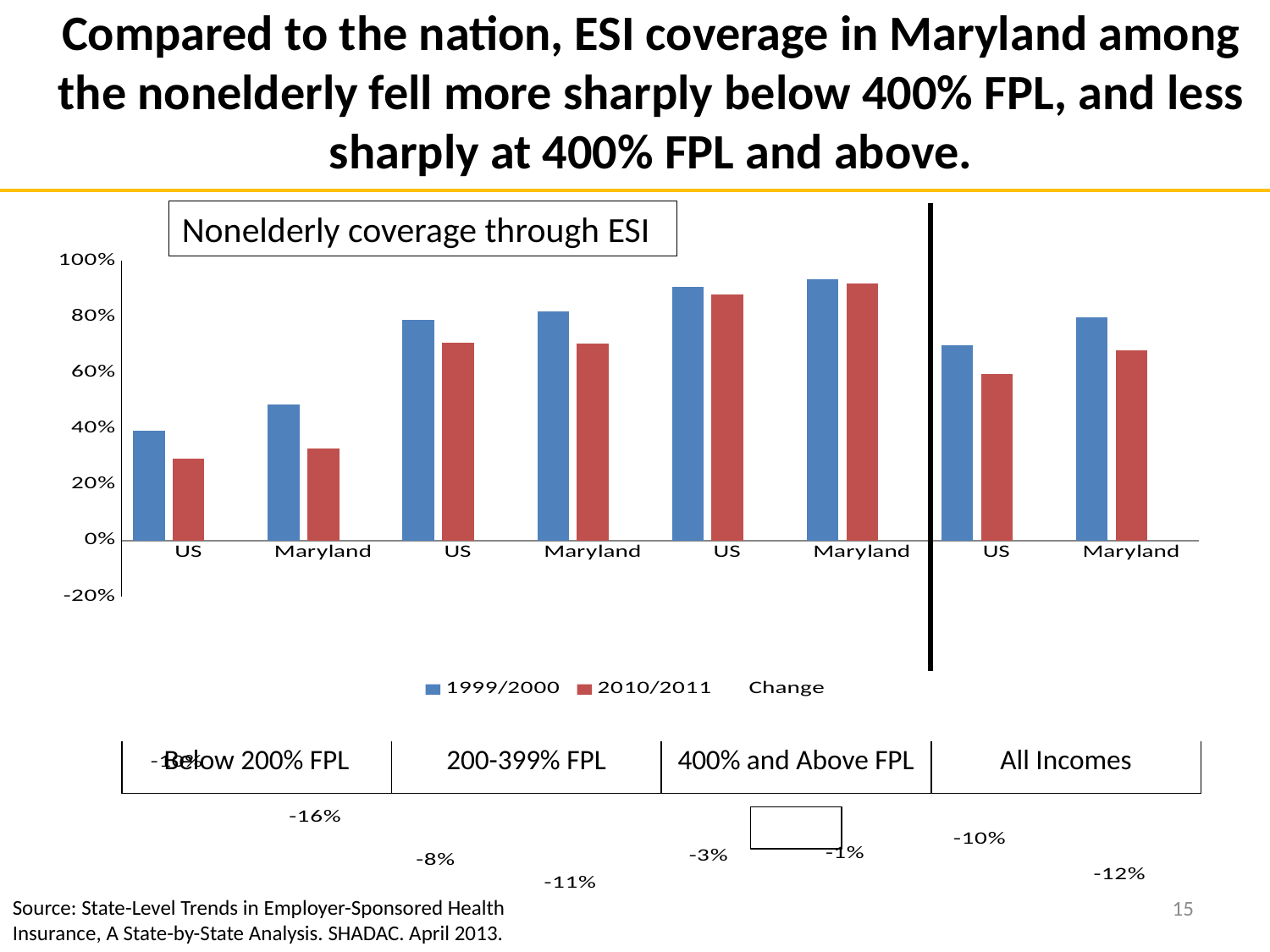
Is the 1999/2000 value for Maryland in the 400% and Above FPL group greater or less than 80%? greater How many income groups are shown along the x axis of the chart? 4 What is the Change value for Maryland in the All Incomes group? -12% In the 200-399% FPL group, how many percentage points larger is the decline for Maryland than for the US? 3 percentage points What kind of chart is shown on the slide? bar chart What is the title of the chart? Nonelderly coverage through ESI What is the Change value for Maryland in the Below 200% FPL group? -16% In the Below 200% FPL group, which had higher 1999/2000 ESI coverage, the US or Maryland? Maryland What is the Change value for Maryland in the 200-399% FPL group? -11% Is the 2010/2011 value for Maryland in the Below 200% FPL group greater or less than 40%? less What is the Change value for the US in the 400% and Above FPL group? -3% How many series does the chart legend list? 3